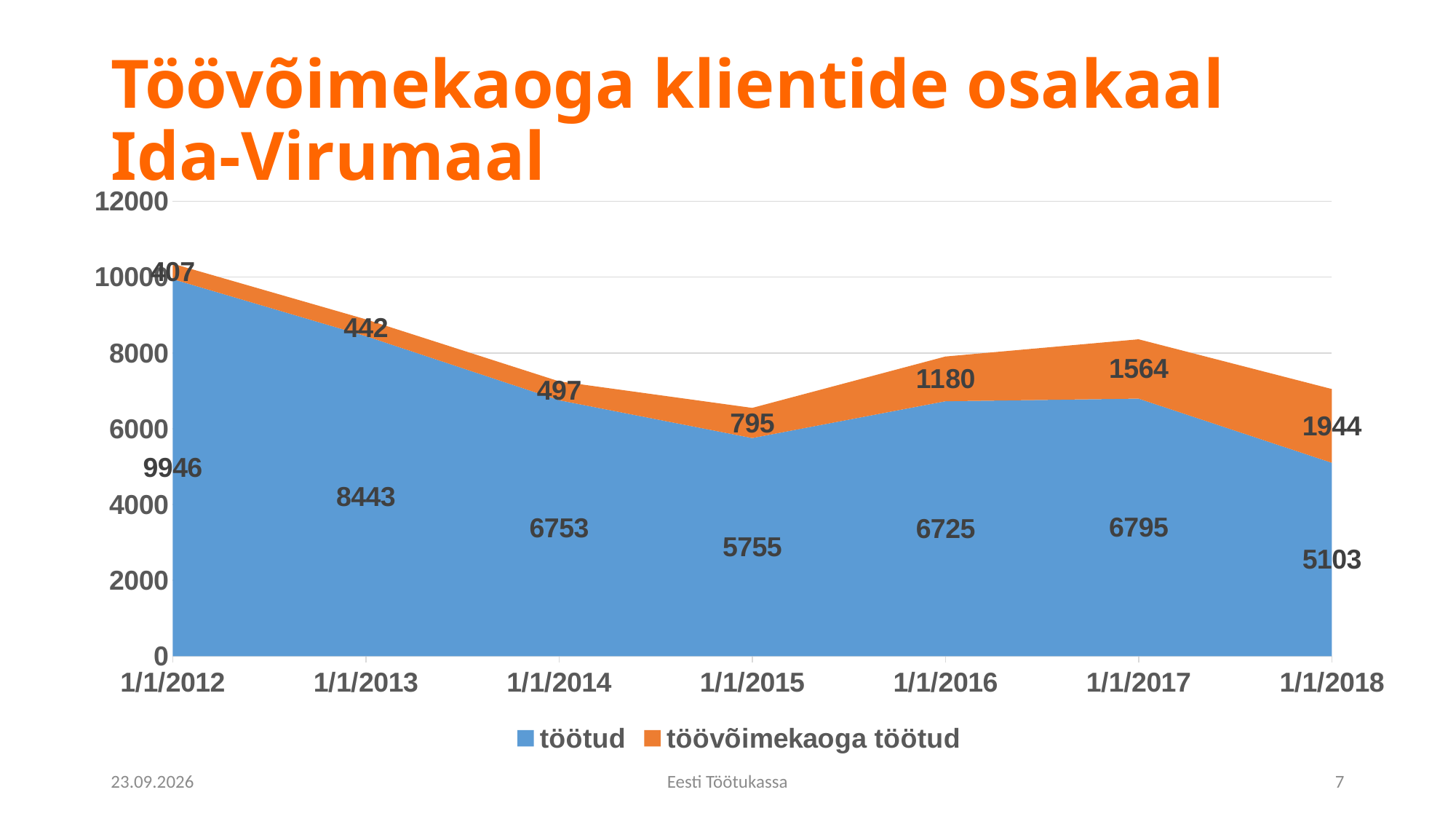
What is the value for töövõimekaoga töötud on 1/1/2017? 1564 In which year is the töötud value lowest? 1/1/2018 What is the value for töötud on 1/1/2015? 5755 What is the difference between the töötud values on 1/1/2012 and 1/1/2013? 1503 How many series does the legend list? 2 Does the töövõimekaoga töötud value rise or fall from 1/1/2012 to 1/1/2018? Rise What kind of chart is shown on the slide? Stacked area chart How many dates are shown on the x axis? 7 What is the combined total of töötud and töövõimekaoga töötud on 1/1/2018? 7047 In which year is the töövõimekaoga töötud value highest? 1/1/2018 What is the value for töötud on 1/1/2012? 9946 Which is larger: töövõimekaoga töötud on 1/1/2016 or on 1/1/2015? 1/1/2016